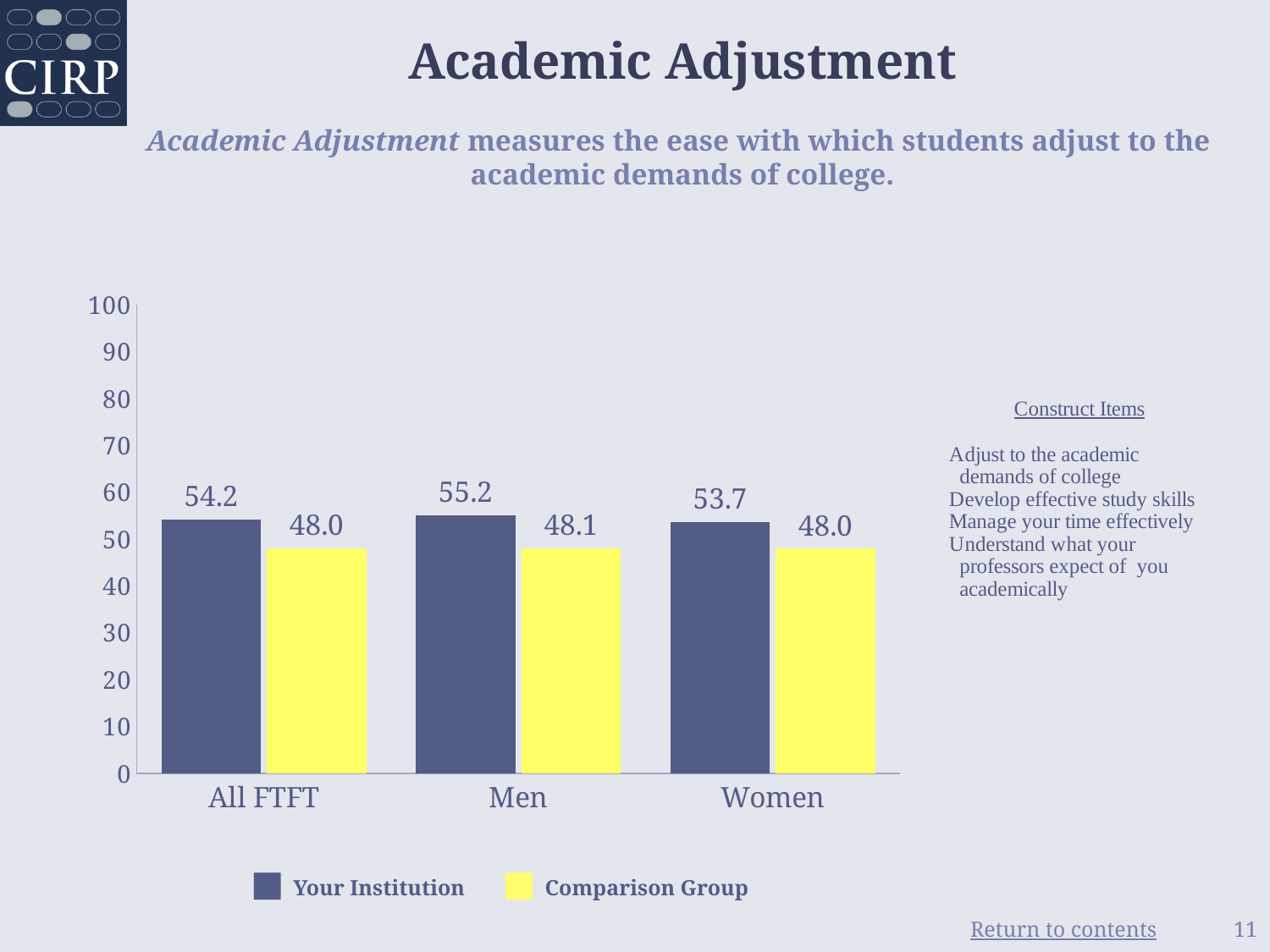
What is the difference between the Your Institution and Comparison Group values for All FTFT? 6.2 What kind of chart is shown on the slide? bar chart How many series does the legend list? 2 Which category has the highest Your Institution value? Men For Women, which is larger: the Your Institution value or the Comparison Group value? Your Institution What is the Your Institution value for All FTFT? 54.2 Is the Comparison Group value for Men greater or less than 50? less How many categories are shown on the x axis? 3 What is the difference between the Your Institution and Comparison Group values for Men? 7.1 Which category has the lowest Your Institution value? Women What is the Your Institution value for Men? 55.2 What is the Comparison Group value for Women? 48.0